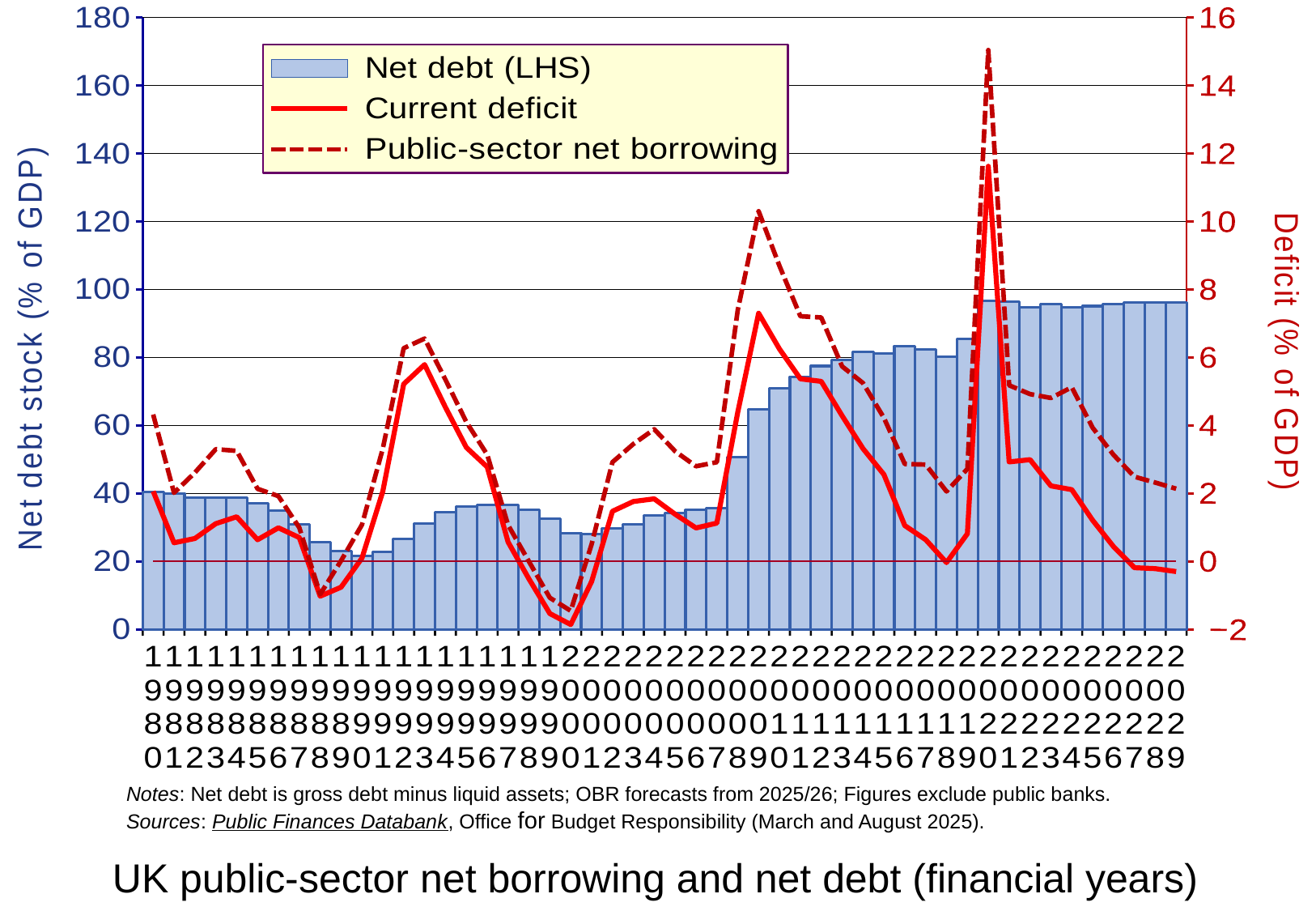
What kind of chart is shown on the slide? A combined bar and line chart How many series does the legend list? 3 How many financial years are plotted along the x axis? 50 Which is larger, the Net debt value for 1990 or for 2010? 2010 Is the Net debt value for 2010 greater or less than 60? greater Is the Public-sector net borrowing value for 2020 greater or less than 14? greater Is the Current deficit value for 2009 greater or less than 6? greater Does Net debt rise or fall between 2008 and 2020? rise In which year does the Current deficit line reach its highest value? 2020 What is the title of the left-hand vertical axis? Net debt stock (% of GDP) In which year does the Public-sector net borrowing line reach its highest value? 2020